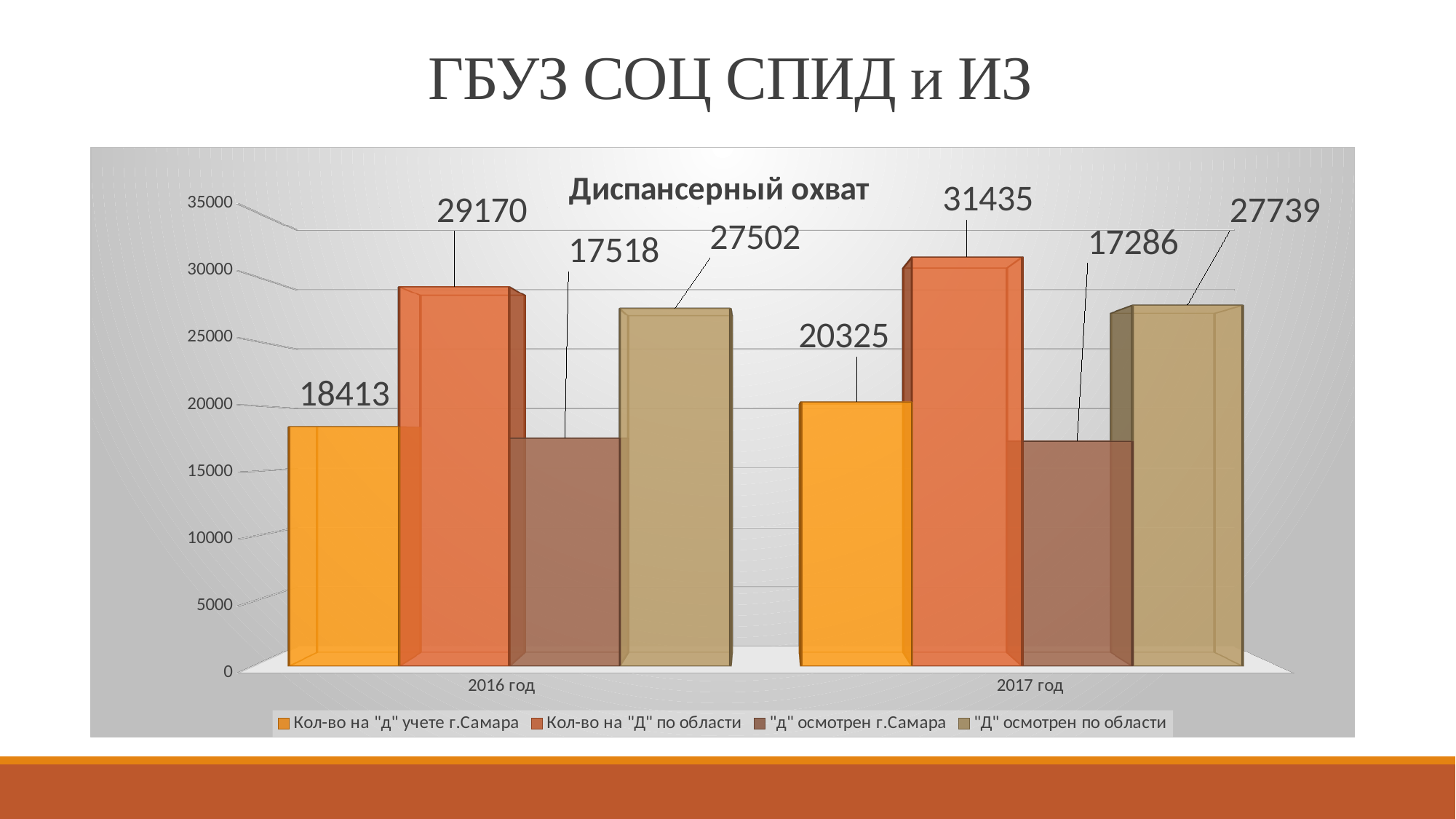
What is the title of the chart? Диспансерный охват What is the value for "Кол-во на "Д" по области" in 2017 год? 31435 What kind of chart is shown on the slide? Bar chart What is the value for "Кол-во на "д" учете г.Самара" in 2016 год? 18413 What is the value for ""д" осмотрен г.Самара" in 2016 год? 17518 Which series has the highest value in 2017 год? Кол-во на "Д" по области Which is larger: "Кол-во на "д" учете г.Самара" in 2016 год or in 2017 год? 2017 год What is the difference between "Кол-во на "Д" по области" in 2017 год and in 2016 год? 2265 What is the value for ""Д" осмотрен по области" in 2017 год? 27739 How many categories are shown on the x axis? 2 Which series has the lowest value in 2016 год? "д" осмотрен г.Самара How many series does the legend list? 4